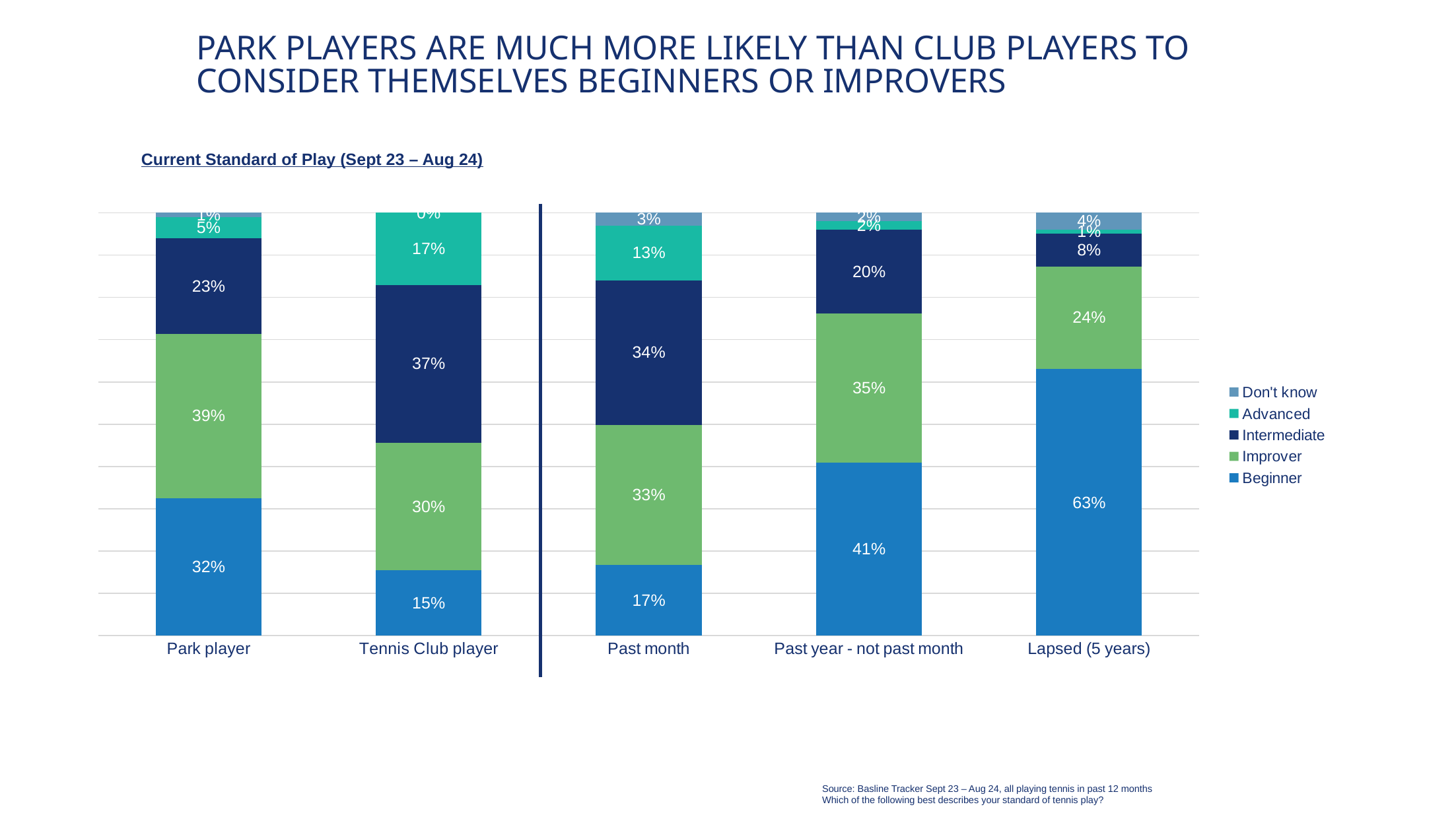
What percentage of Park players consider themselves Beginners? 32% What kind of chart is shown on the slide? Stacked bar chart What is the Intermediate share for Tennis Club players? 37% Which category has the lowest Beginner share? Tennis Club player What percentage of Lapsed (5 years) players are Beginners? 63% Which category has the highest Beginner share? Lapsed (5 years) How many categories are shown on the x axis? 5 Which is larger: the Advanced share for Tennis Club players or for Park players? Tennis Club player What is the title of the chart? Current Standard of Play (Sept 23 – Aug 24) What is the difference between the Improver share for Park players and for Tennis Club players? 9 percentage points What is the Advanced share for the Past month group? 13% How many series does the legend list? 5